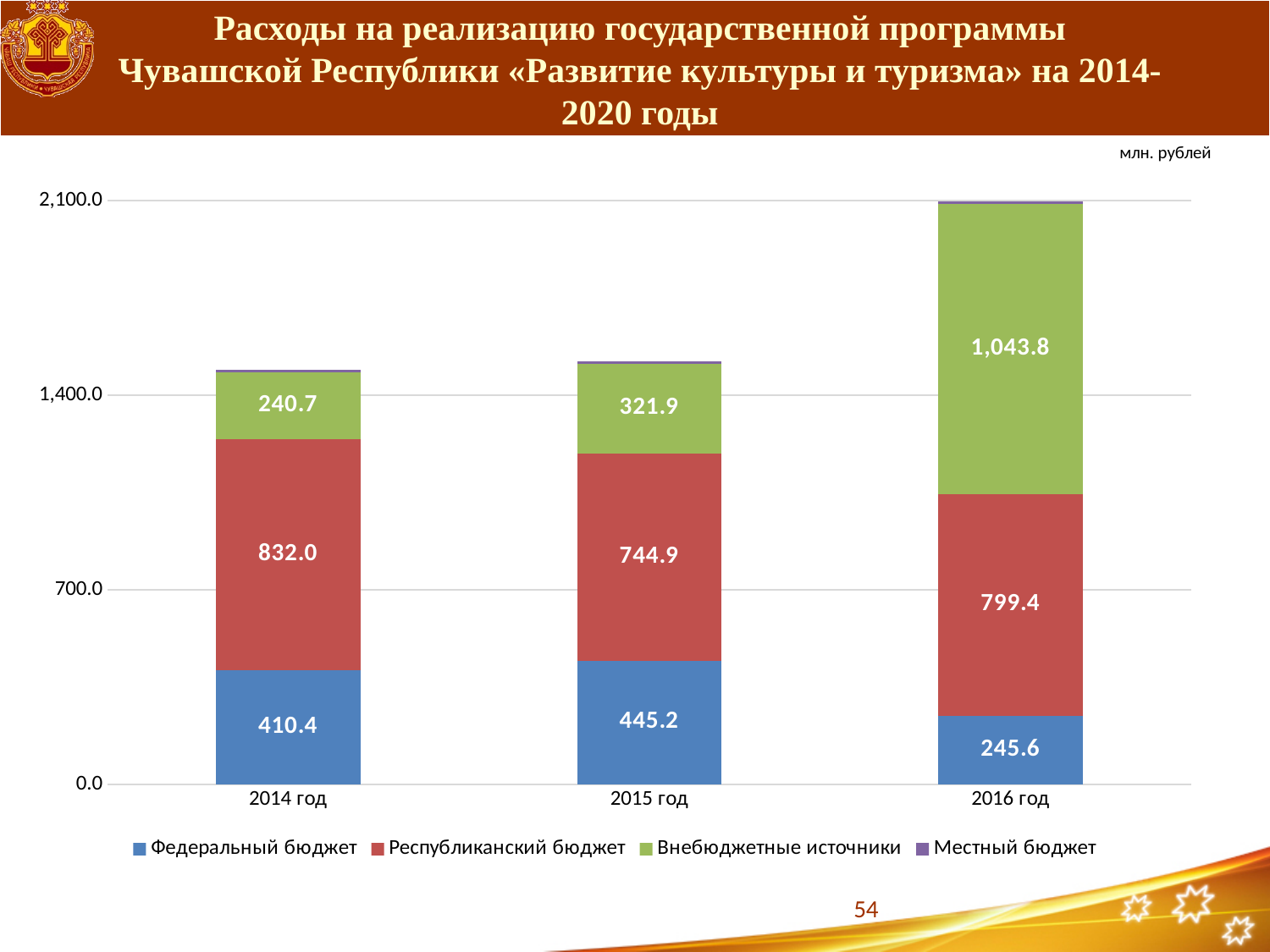
How many years are shown on the x axis? 3 What is the value for Внебюджетные источники in 2016 год? 1,043.8 Which is larger: Федеральный бюджет in 2014 год or in 2015 год? 2015 год What kind of chart is shown on the slide? Stacked bar chart Is the total height of the 2016 год bar greater or less than 1,400.0? greater What is the value for Республиканский бюджет in 2015 год? 744.9 What is the value for Федеральный бюджет in 2016 год? 245.6 In which year is the Федеральный бюджет value the lowest? 2016 год What is the value for Федеральный бюджет in 2014 год? 410.4 In which year is the Внебюджетные источники value the highest? 2016 год What is the difference between the Республиканский бюджет values for 2014 год and 2015 год? 87.1 How many series does the legend list? 4